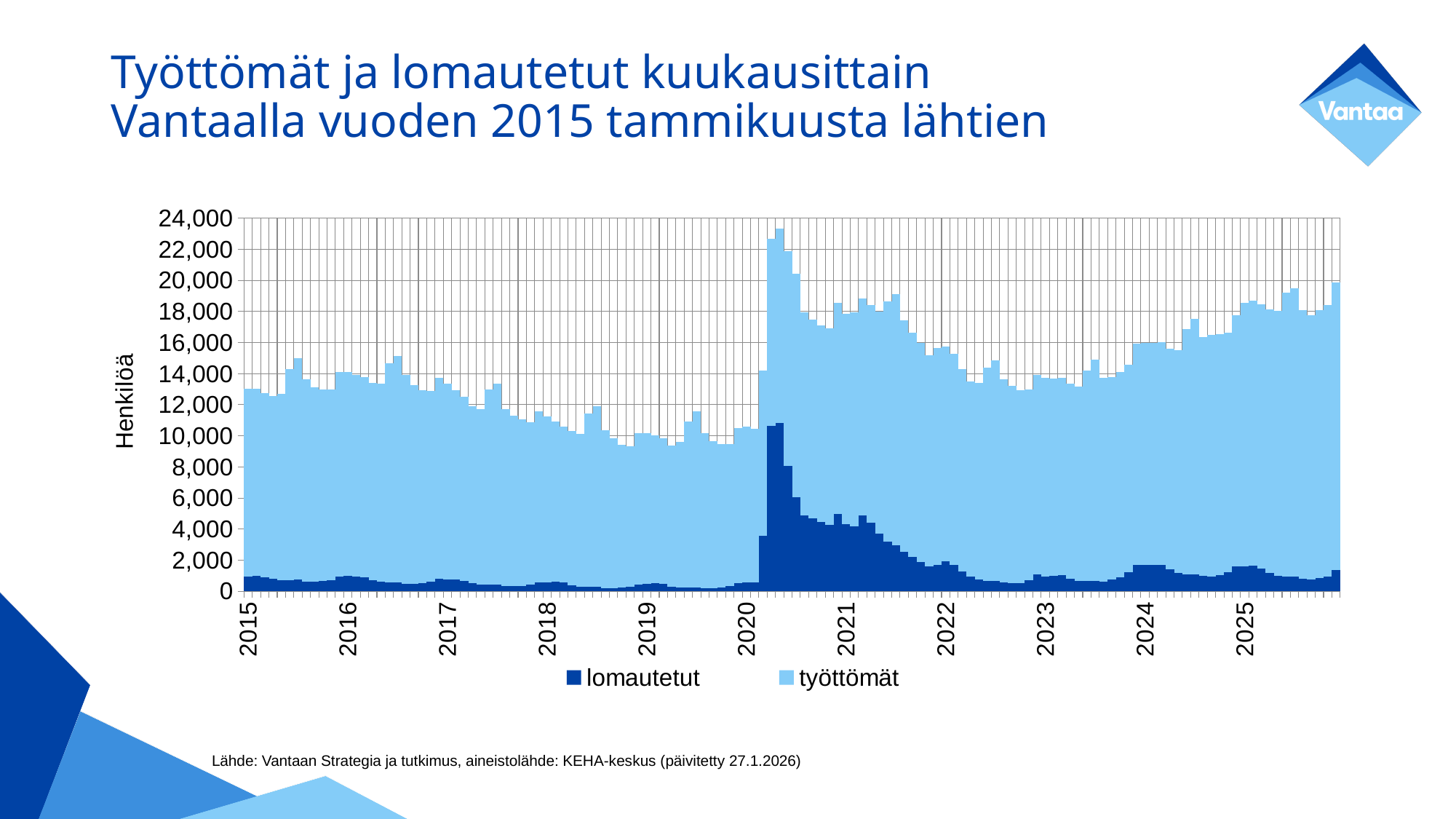
How many series does the legend list? 2 Is the stacked total at the end of 2025 greater or less than 18,000? greater Which series is larger in 2018, lomautetut or työttömät? työttömät What is the label on the vertical axis? Henkilöä Is the value of lomautetut during 2017 greater or less than 2,000? less What are the two series named in the legend? lomautetut and työttömät How many year labels are shown on the horizontal axis? 11 In which year does the stacked total reach its highest peak? 2020 What kind of chart is shown on the slide? stacked bar chart Is the peak value of lomautetut in 2020 greater or less than 10,000? greater Does the stacked total generally rise or fall from 2022 to 2025? rise